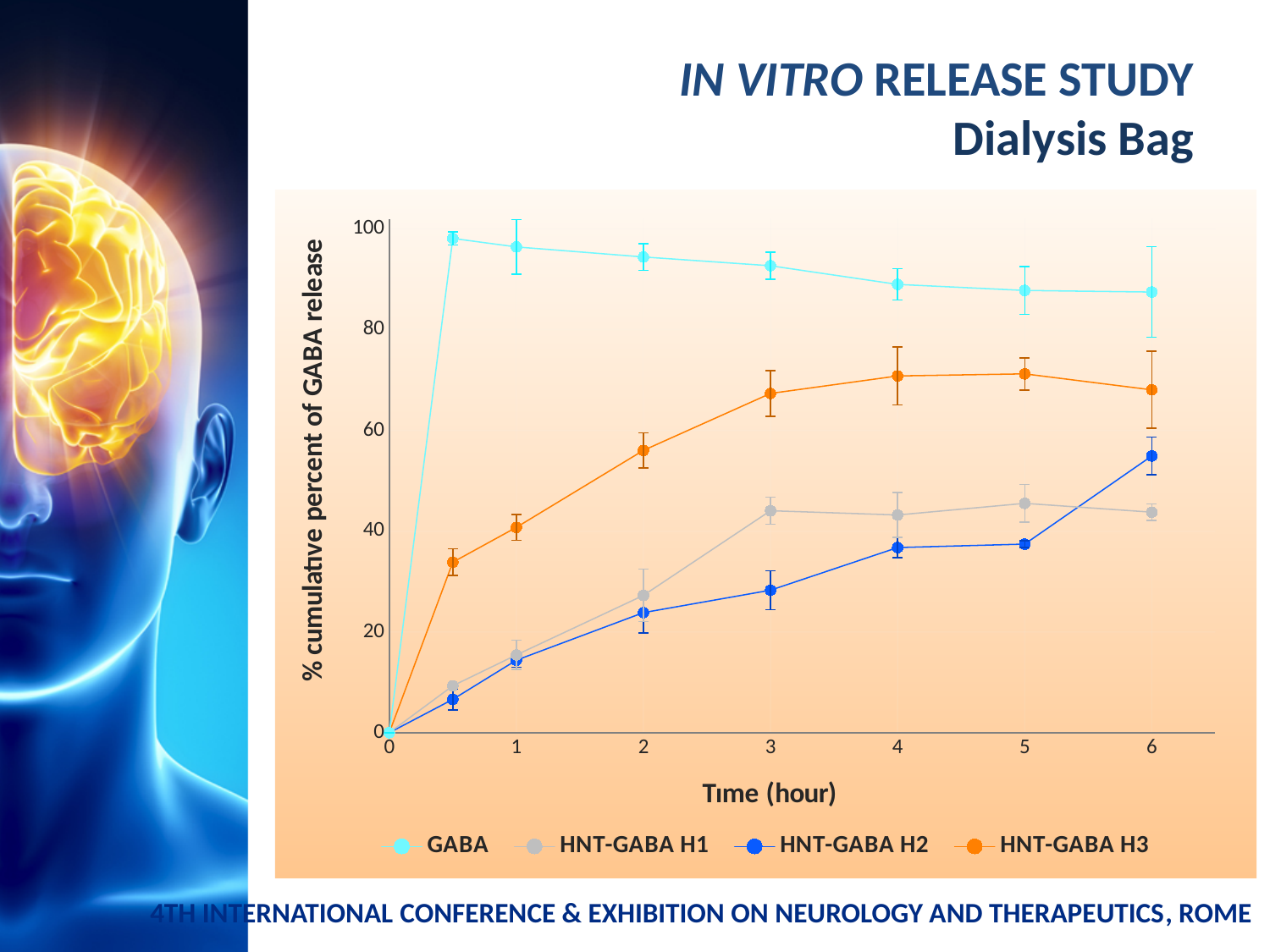
Is the value for HNT-GABA H3 at 6 hours greater or less than 60? greater Is the value for HNT-GABA H2 at 1 hour greater or less than 20? less Is the value for GABA at 1 hour greater or less than 80? greater Which series has the lowest value at 3 hours? HNT-GABA H2 At 6 hours, which is larger: HNT-GABA H2 or HNT-GABA H1? HNT-GABA H2 Which series has the highest value at 6 hours? GABA How many time points are plotted for each series? 8 How many series does the legend list? 4 Does the GABA series rise or fall from 0.5 hours to 6 hours? fall What is the title of the x axis? Time (hour) What kind of chart is shown on the slide? line chart